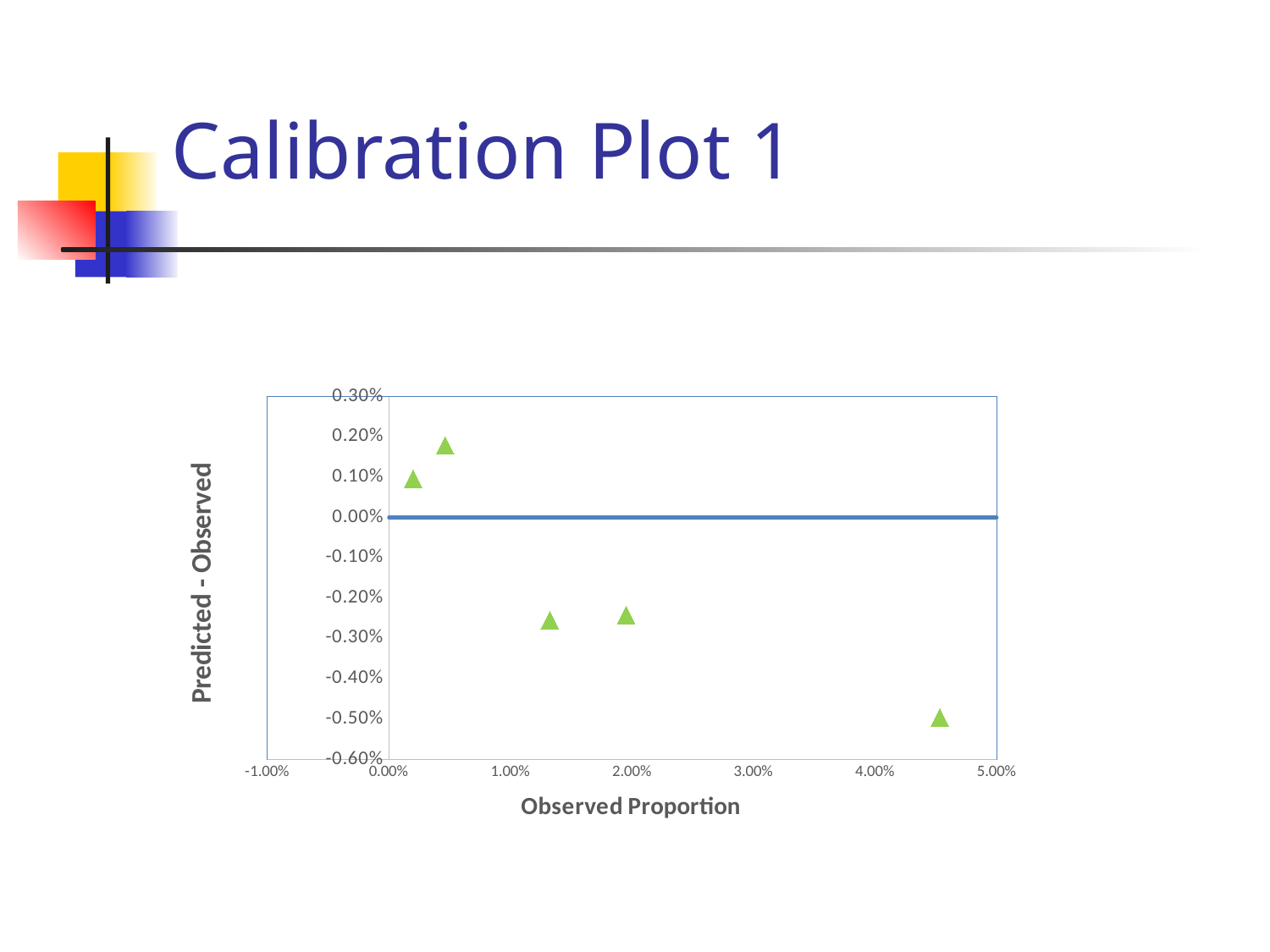
How many data points lie below the 0.00% line? 3 What kind of chart is shown on the slide? scatter plot Is the value for the point near an observed proportion of 2.00% greater or less than -0.20%? less What is the title of the y axis? Predicted - Observed Overall, do the Predicted - Observed values rise or fall as the observed proportion increases? fall How many data points lie above the 0.00% line? 2 Is the value for the point near an observed proportion of 0.50% greater or less than 0.10%? greater How many data points are plotted on the chart? 5 Which point has the lowest Predicted - Observed value: the one near 2.00% observed proportion or the one near 4.50%? the one near 4.50% What is the title of the x axis? Observed Proportion Is the value for the point with the largest observed proportion (near 4.50%) greater or less than -0.40%? less